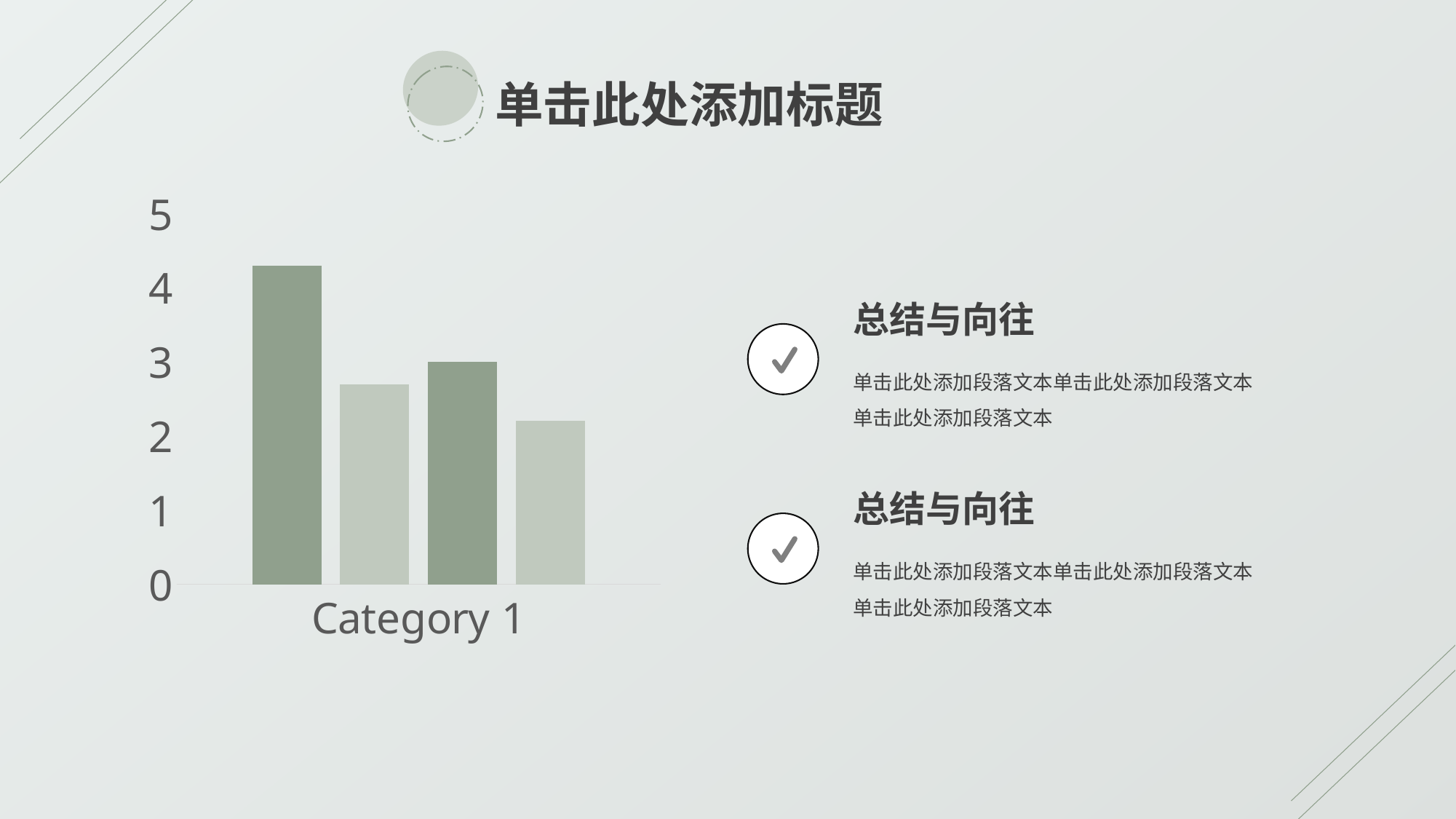
What is the label of the category on the x axis? Category 1 Which is larger, the first bar or the second bar from the left? the first bar Is the value of the rightmost bar greater or less than 3? less How many bars are plotted in the chart? 4 Is the value of the leftmost bar greater or less than 4? greater How many categories are shown on the x axis of the chart? 1 What kind of chart is shown on the slide? bar chart What is the highest value shown on the y axis of the chart? 5 Which bar is the tallest in the chart? the leftmost (first) bar Is the value of the rightmost bar greater or less than 2? greater Which bar is the shortest in the chart? the rightmost (fourth) bar